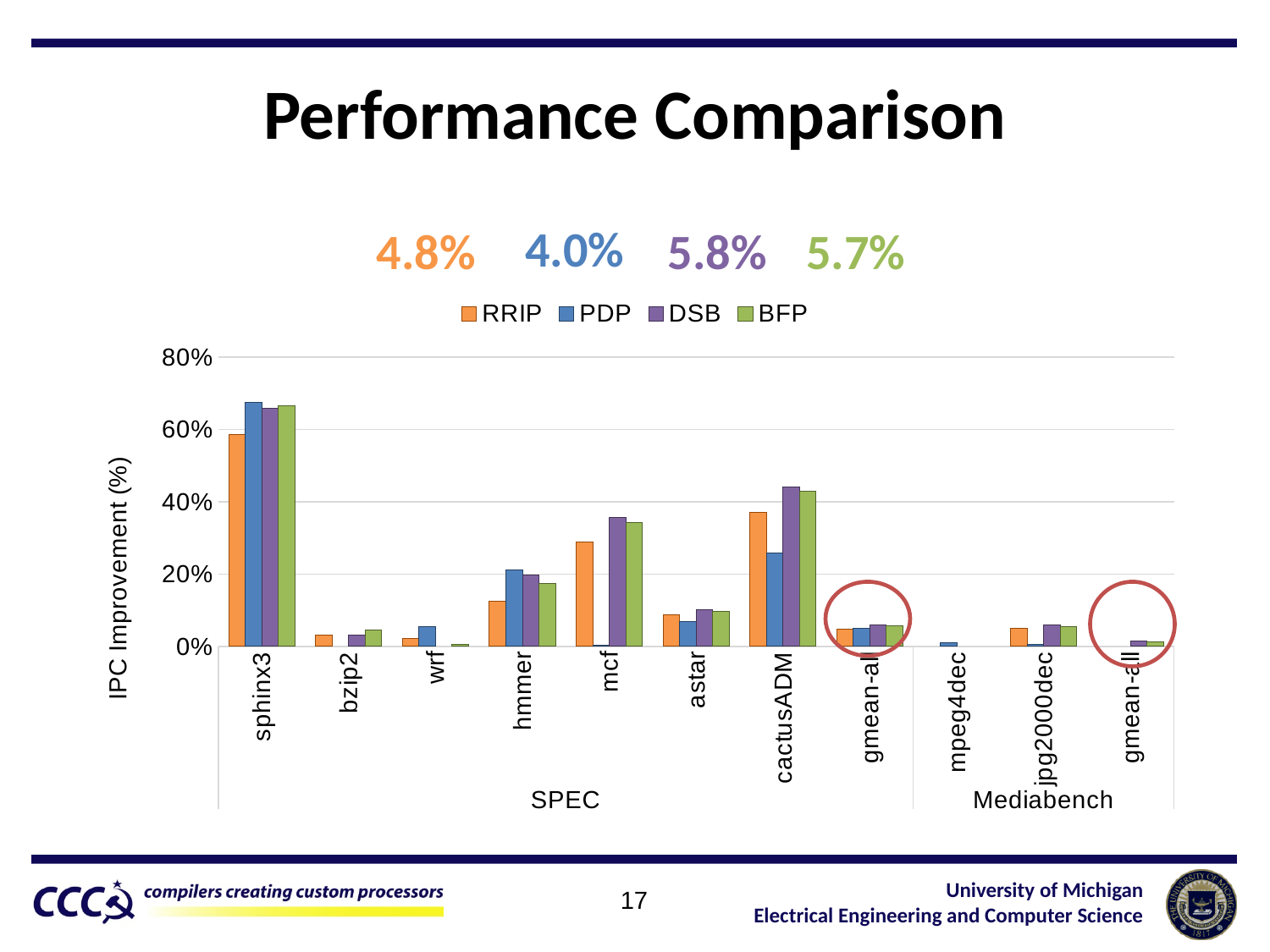
What is the label on the y axis? IPC Improvement (%) For mcf, which series has the lowest value? PDP Is the PDP value for cactusADM greater or less than 20%? greater How many benchmark categories are shown along the x axis? 11 Is the RRIP value for sphinx3 greater or less than 40%? greater What four percentages are printed above the legend? 4.8%, 4.0%, 5.8%, 5.7% For mcf, which is larger: the RRIP value or the DSB value? DSB How many series does the legend list? 4 What kind of chart is shown on the slide? bar chart Which benchmark has the highest IPC improvement values? sphinx3 Is the DSB value for astar greater or less than 20%? less